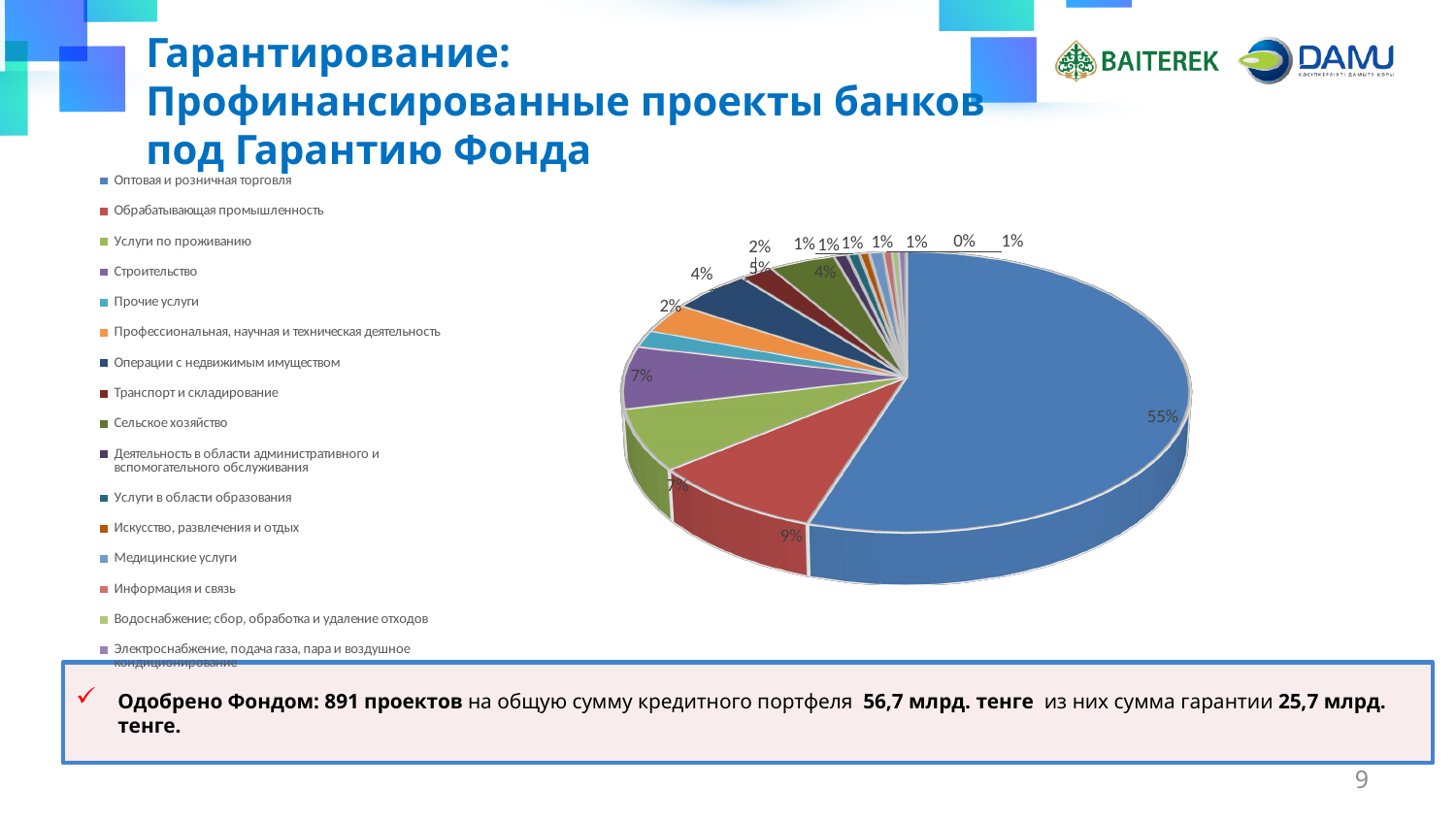
What kind of chart is shown on the slide? Pie chart What share of the pie does "Оптовая и розничная торговля" hold? 55% According to the text box below the chart, how many projects were approved by the Fund? 891 проектов Which is larger: the slice for "Обрабатывающая промышленность" or the slice for "Услуги по проживанию"? Обрабатывающая промышленность What is the value shown for "Обрабатывающая промышленность"? 9% What colour is the slice for "Оптовая и розничная торговля"? Blue What is the value shown for "Прочие услуги"? 2% What is the value shown for "Строительство"? 7% How many categories does the legend list? 16 By how many percentage points does "Оптовая и розничная торговля" exceed "Обрабатывающая промышленность"? 46 percentage points Which category has the largest slice of the pie? Оптовая и розничная торговля What is the value shown for "Услуги по проживанию"? 7%